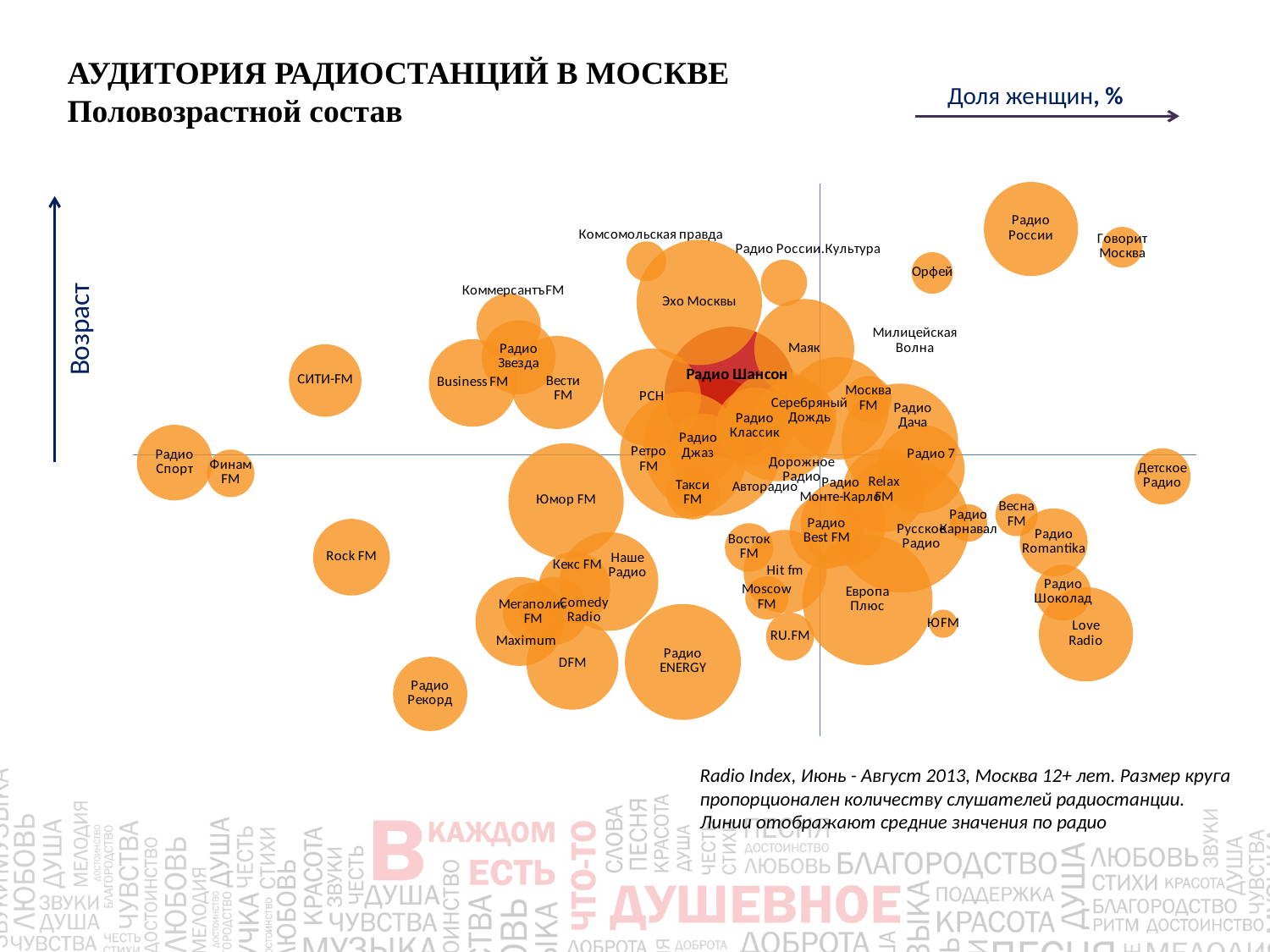
Which station has a higher share of women: Говорит Москва or СИТИ-FM? Говорит Москва Which station has a higher share of women: Радио Спорт or Детское Радио? Детское Радио What does the vertical axis of the chart represent? Возраст Which radio station is positioned furthest to the right, i.e. has the highest share of women? Детское Радио What kind of chart is shown on the slide? Bubble chart Which radio station is positioned highest on the age (Возраст) axis? Радио России Which radio station is positioned furthest to the left, i.e. has the lowest share of women? Радио Спорт Is the share of women for Rock FM above or below the average line for radio? Below Is the audience age for Эхо Москвы above or below the average line for radio? Above Which radio station is positioned lowest on the age (Возраст) axis? Радио Рекорд Which station has an older audience: Радио России or Радио ENERGY? Радио России What does the horizontal axis of the chart represent? Доля женщин, %